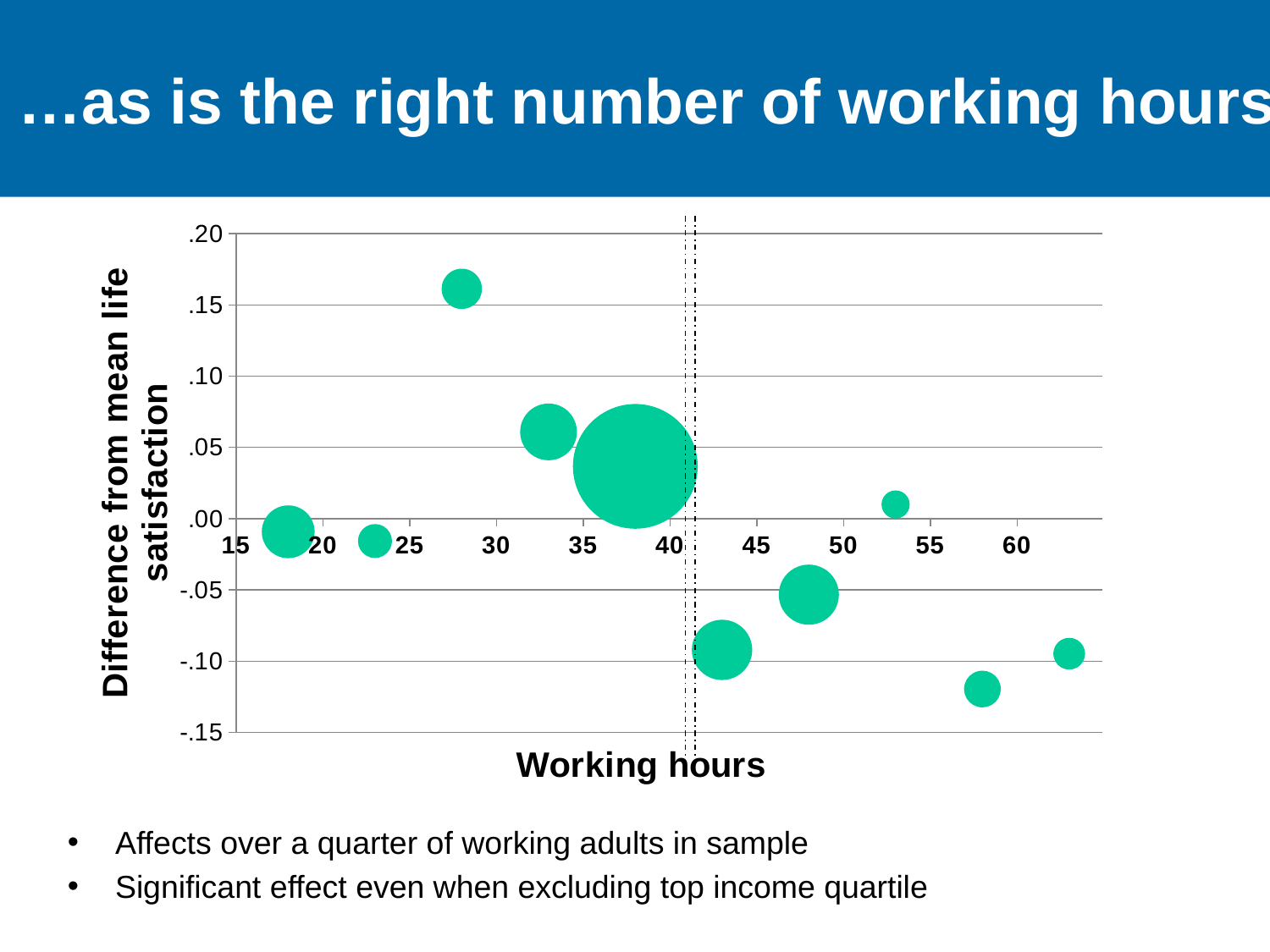
Which bubble has a higher value: the one at about 33 working hours or the one at about 43 working hours? The one at about 33 working hours Is the value for the bubble at about 33 working hours greater or less than .05? greater What is the title of the x axis? Working hours Is the value for the bubble at about 48 working hours greater or less than .00? less What kind of chart is shown on the slide? Bubble chart Is the value for the bubble at about 28 working hours greater or less than .10? greater How many bubbles are plotted on the chart? 10 What is the title of the y axis? Difference from mean life satisfaction